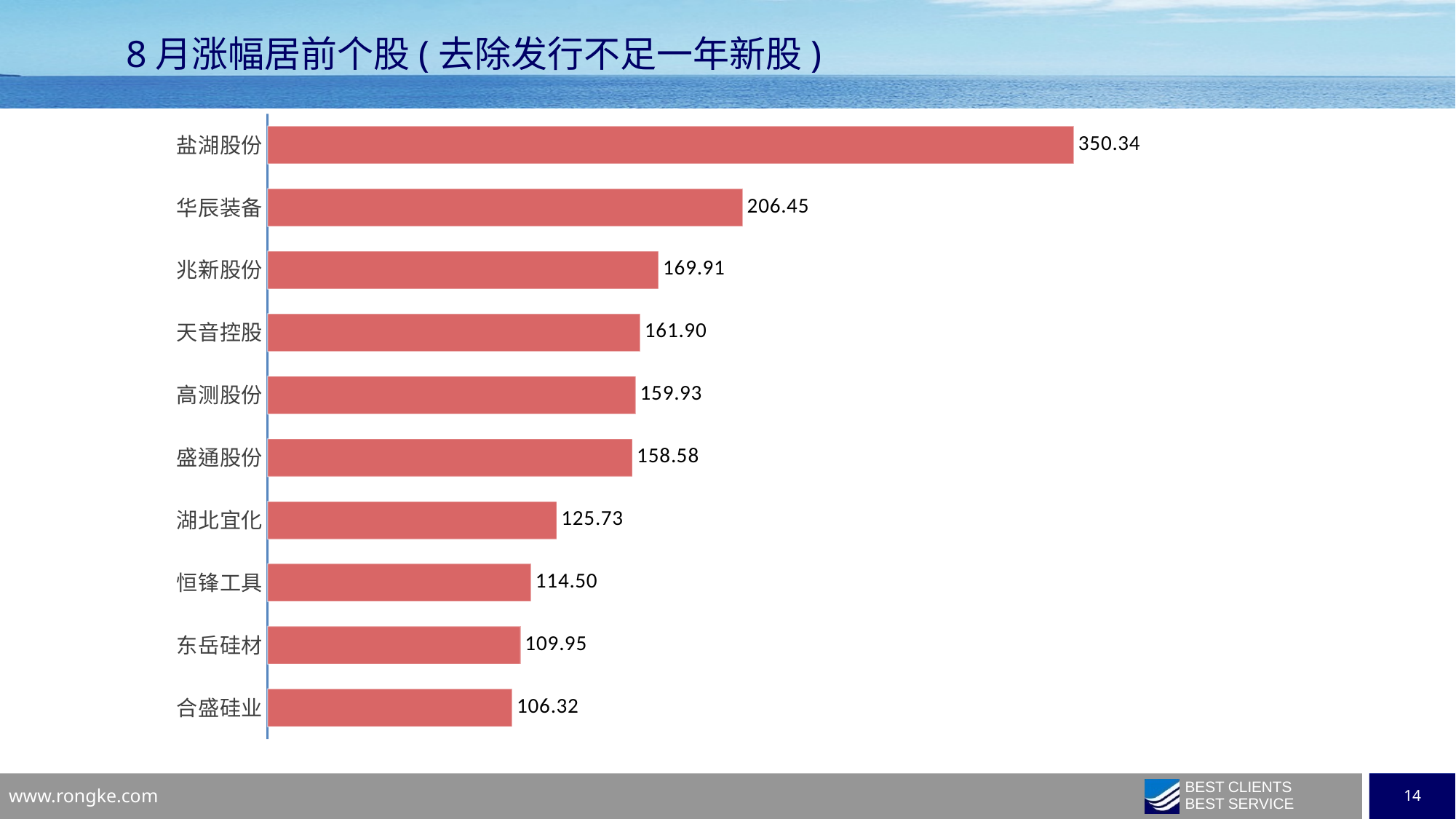
Which is larger, the value for 恒锋工具 or the value for 盛通股份? 盛通股份 What is the difference between the values for 盐湖股份 and 华辰装备? 143.89 How many stocks are shown in the chart? 10 What is the value for 湖北宜化? 125.73 Which is larger, the value for 华辰装备 or the value for 兆新股份? 华辰装备 What is the title of the slide? 8 月涨幅居前个股 ( 去除发行不足一年新股 ) What is the value for 盐湖股份? 350.34 What is the value for 东岳硅材? 109.95 What kind of chart is shown on the slide? Bar chart Which stock has the highest value in the chart? 盐湖股份 Which stock has the lowest value in the chart? 合盛硅业 What is the difference between the values for 湖北宜化 and 合盛硅业? 19.41